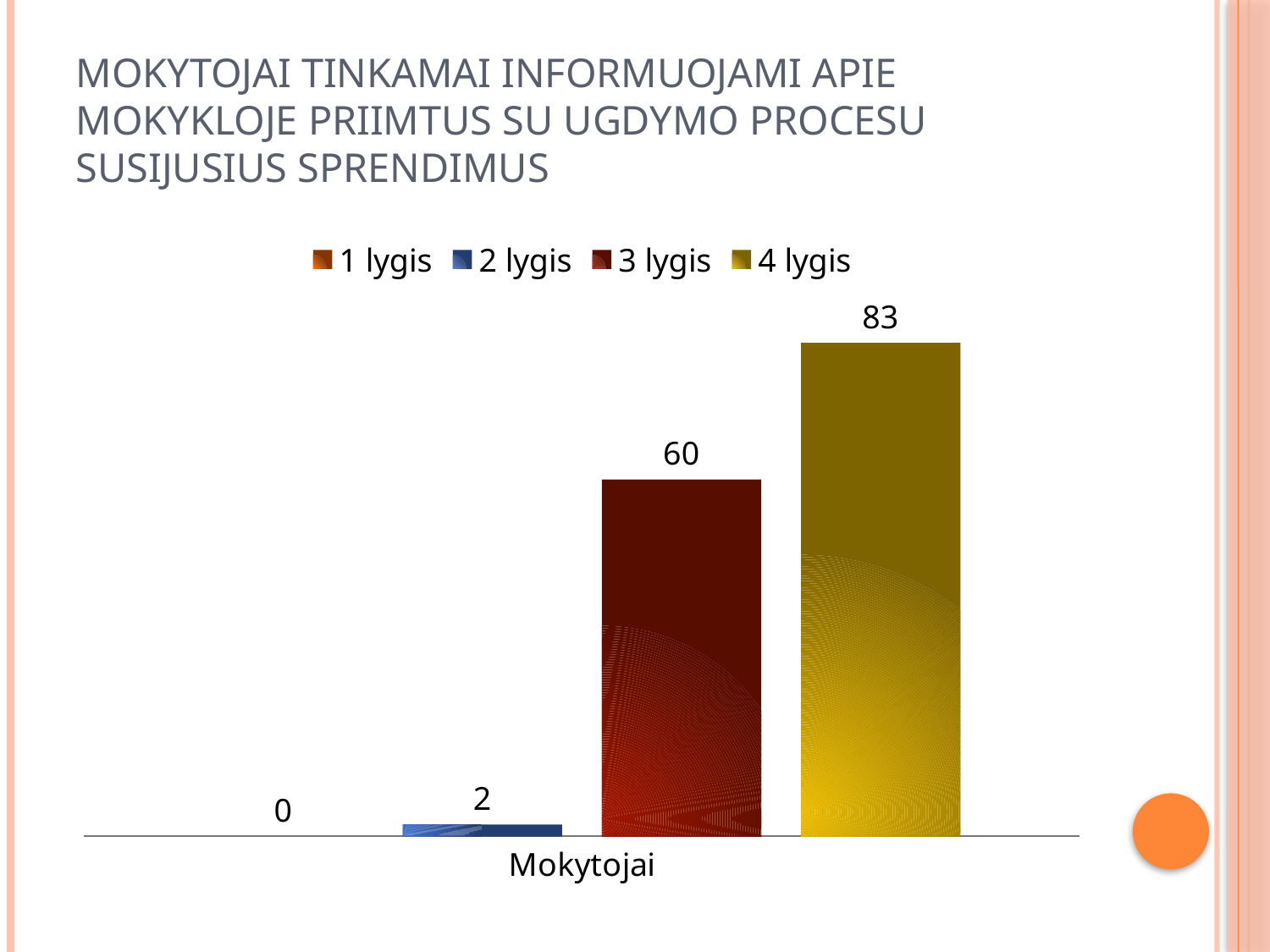
What colour is the bar for 4 lygis? Yellow What is the value for 2 lygis? 2 Which series has the lowest value? 1 lygis What is the value for 4 lygis? 83 What is the value for 1 lygis? 0 What is the value for 3 lygis? 60 Which is larger, the value for 3 lygis or the value for 2 lygis? 3 lygis What is the difference between the values for 4 lygis and 3 lygis? 23 What is the category label shown on the x axis? Mokytojai Which series has the highest value? 4 lygis How many series does the legend list? 4 What kind of chart is shown on the slide? Bar chart